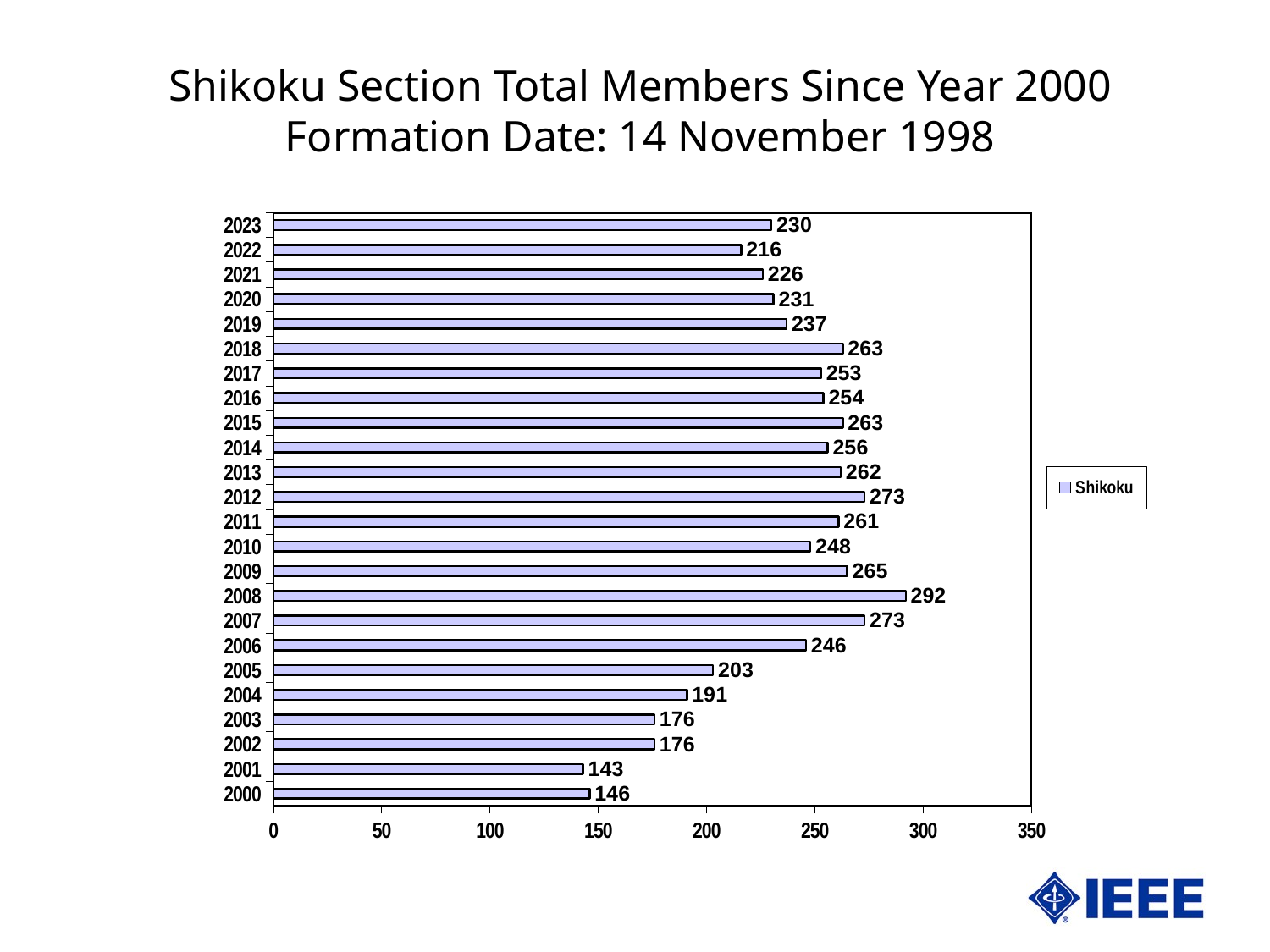
What is the value for 2023? 230 How many years are shown on the chart? 24 Which year has the highest value? 2008 What kind of chart is this? bar chart What is the value for 2008? 292 Which is larger, the value for 2012 or the value for 2013? 2012 What series name is shown in the legend? Shikoku How many series does the legend list? 1 What is the value for 2000? 146 Is the value for 2005 greater or less than 200? greater What is the difference between the values for 2008 and 2023? 62 Which year has the lowest value? 2001